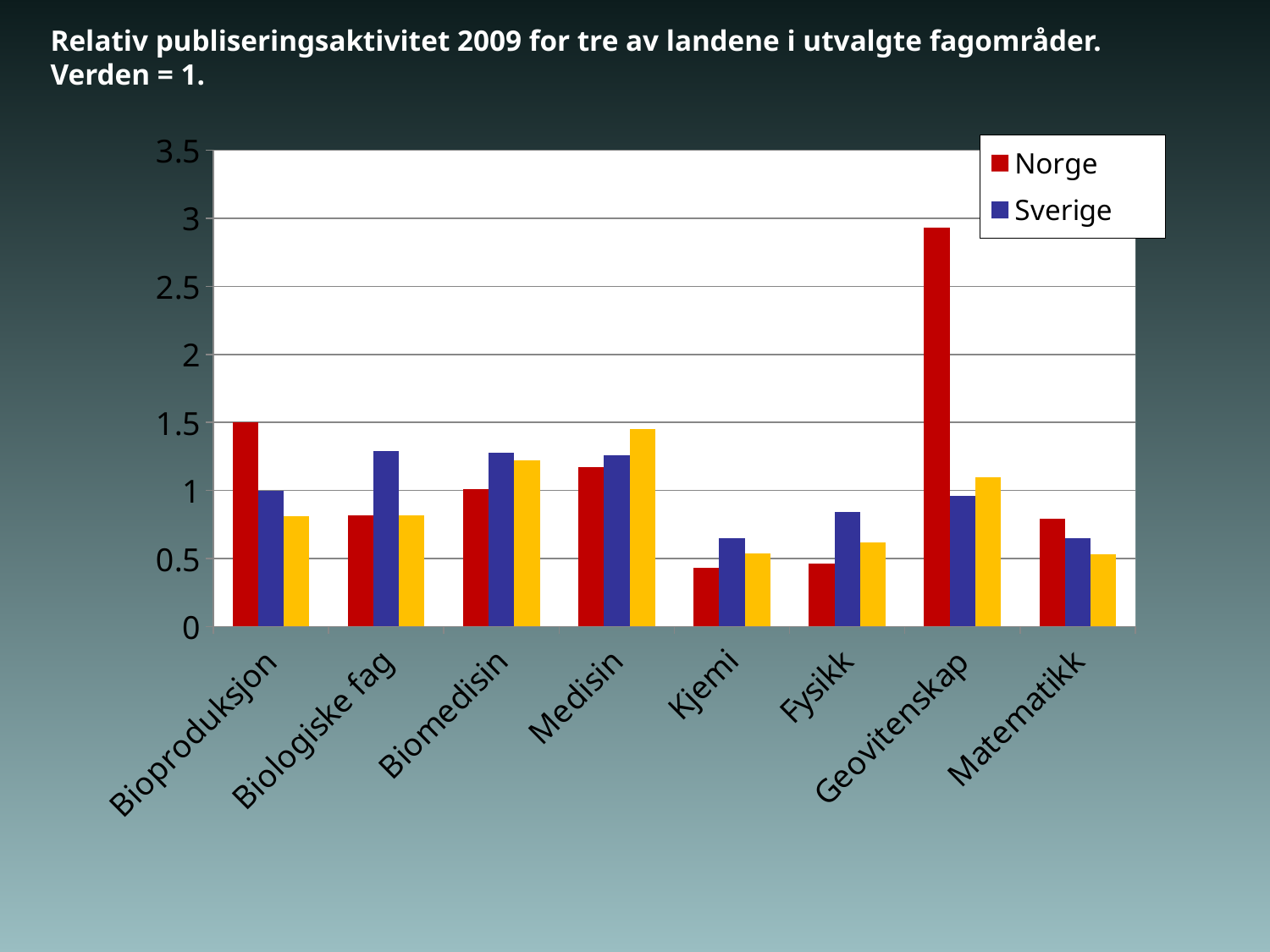
What colour are the bars for Norge? red Which two series are named in the legend? Norge and Sverige Which category has the highest value for Norge? Geovitenskap In Fysikk, which is larger: the value for Norge or for Sverige? Sverige In Biologiske fag, which is larger: the value for Norge or for Sverige? Sverige Is the value for Norge in Geovitenskap greater or less than 2.5? greater Is the value for Norge in Medisin greater or less than 1? greater What kind of chart is shown on the slide? bar chart In Bioproduksjon, which is larger: the value for Norge or for Sverige? Norge Is the value for Sverige in Biologiske fag greater or less than 1? greater How many subject categories are shown on the x axis? 8